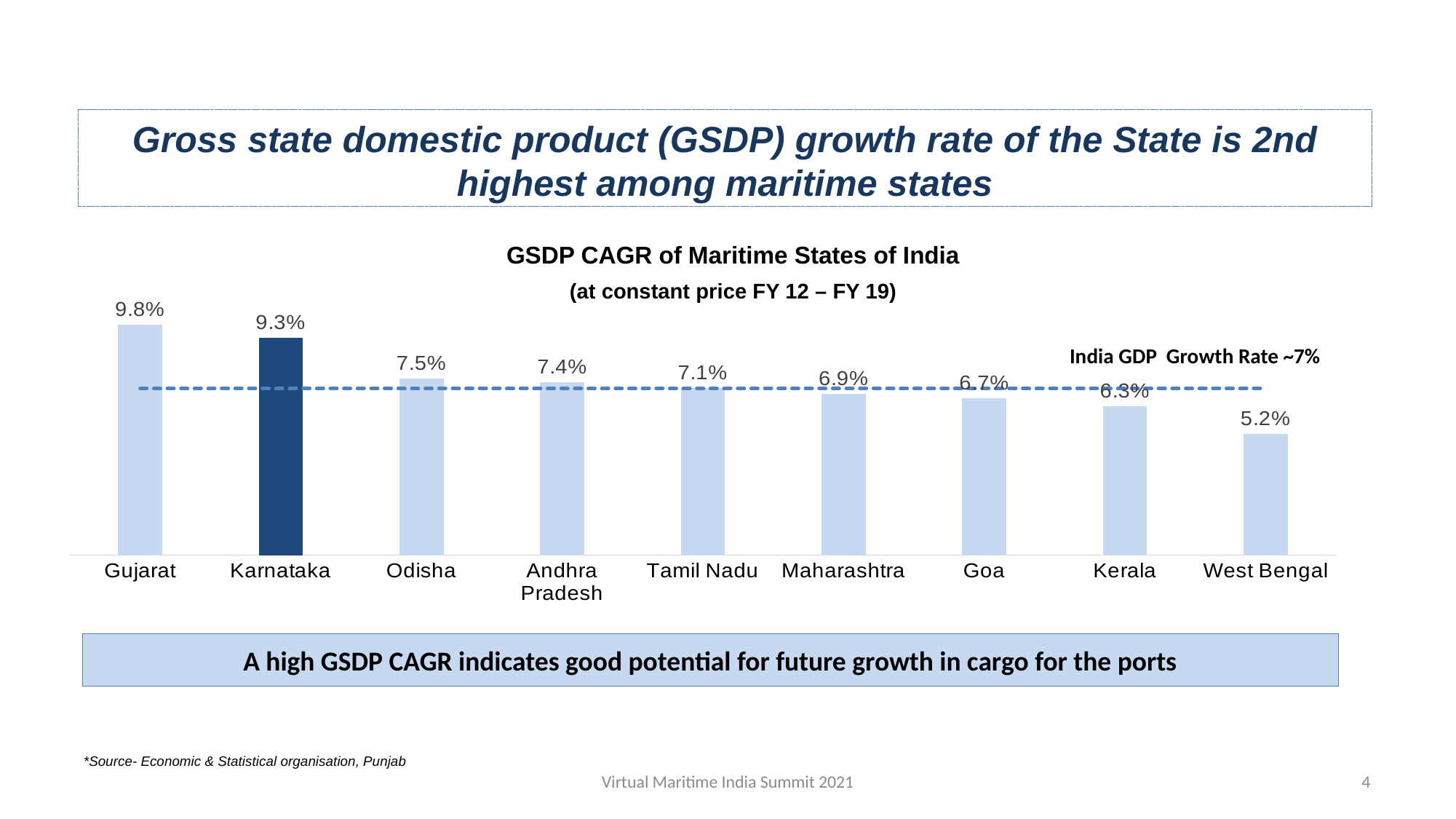
What is the GSDP CAGR for Karnataka? 9.3% Do the GSDP CAGR values rise or fall from left to right across the states? Fall What is the GSDP CAGR for West Bengal? 5.2% Which has a higher GSDP CAGR, Odisha or Maharashtra? Odisha What is the GSDP CAGR for Tamil Nadu? 7.1% Which state has the highest GSDP CAGR? Gujarat What type of chart is used to show the GSDP CAGR of maritime states? Bar chart What is the GSDP CAGR for Gujarat? 9.8% What is the difference between the GSDP CAGR of Gujarat and Karnataka? 0.5% How many states are shown in the chart? 9 Which state has the lowest GSDP CAGR? West Bengal What is the title of the chart? GSDP CAGR of Maritime States of India